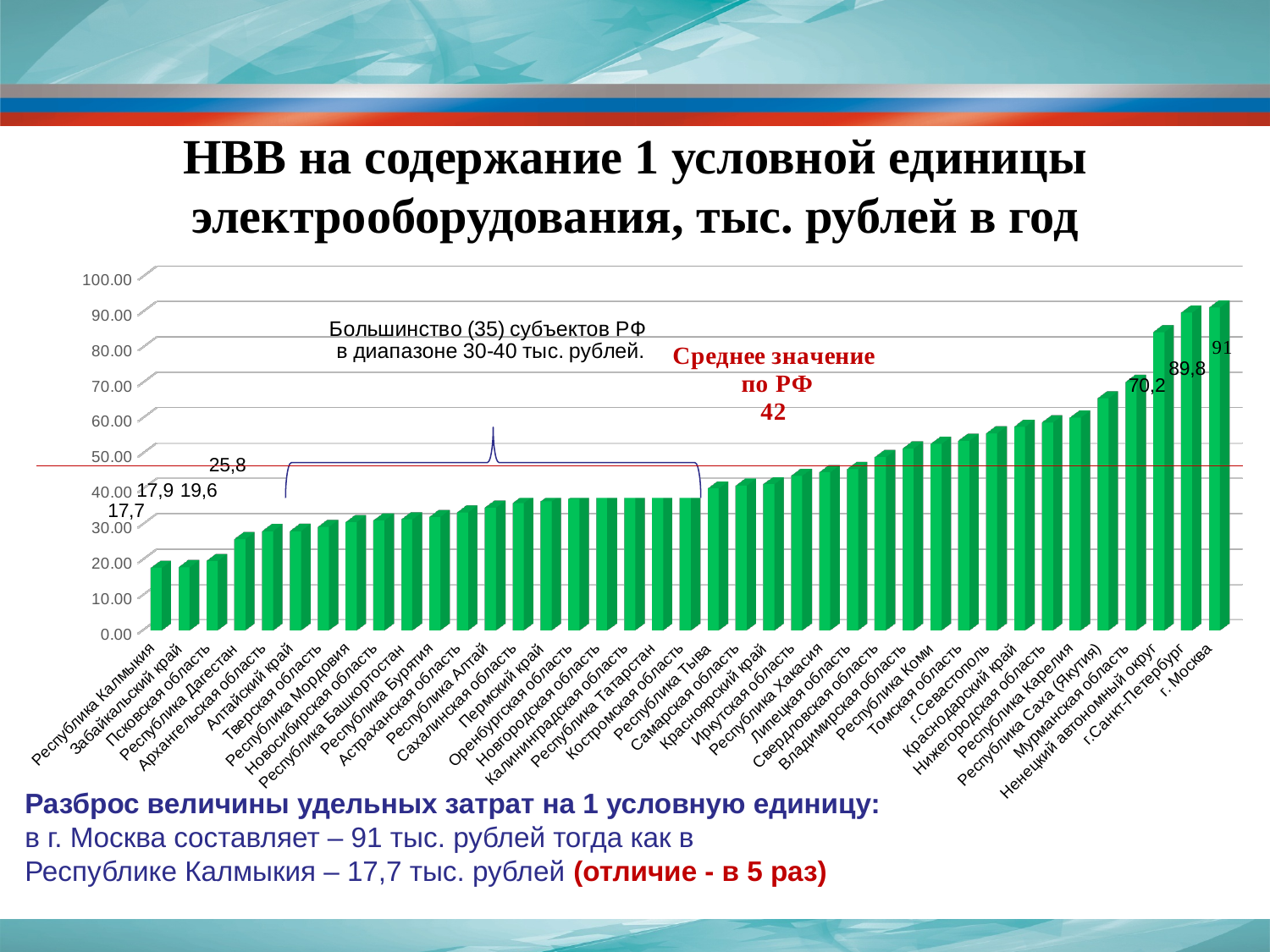
Do the values rise or fall from left to right along the x axis? rise What is the value for Республика Дагестан? 25,8 What average value for the Russian Federation (Среднее значение по РФ) is marked on the chart? 42 What is the difference between the values for г. Москва and Республика Калмыкия? 73,3 What kind of chart is shown on the slide? bar chart What is the value for г.Санкт-Петербург? 89,8 Which is larger, the value for г.Санкт-Петербург or for Ненецкий автономный округ? г.Санкт-Петербург What is the value for Республика Калмыкия? 17,7 What is the value for г. Москва? 91 Which region has the highest value? г. Москва Which region has the lowest value? Республика Калмыкия